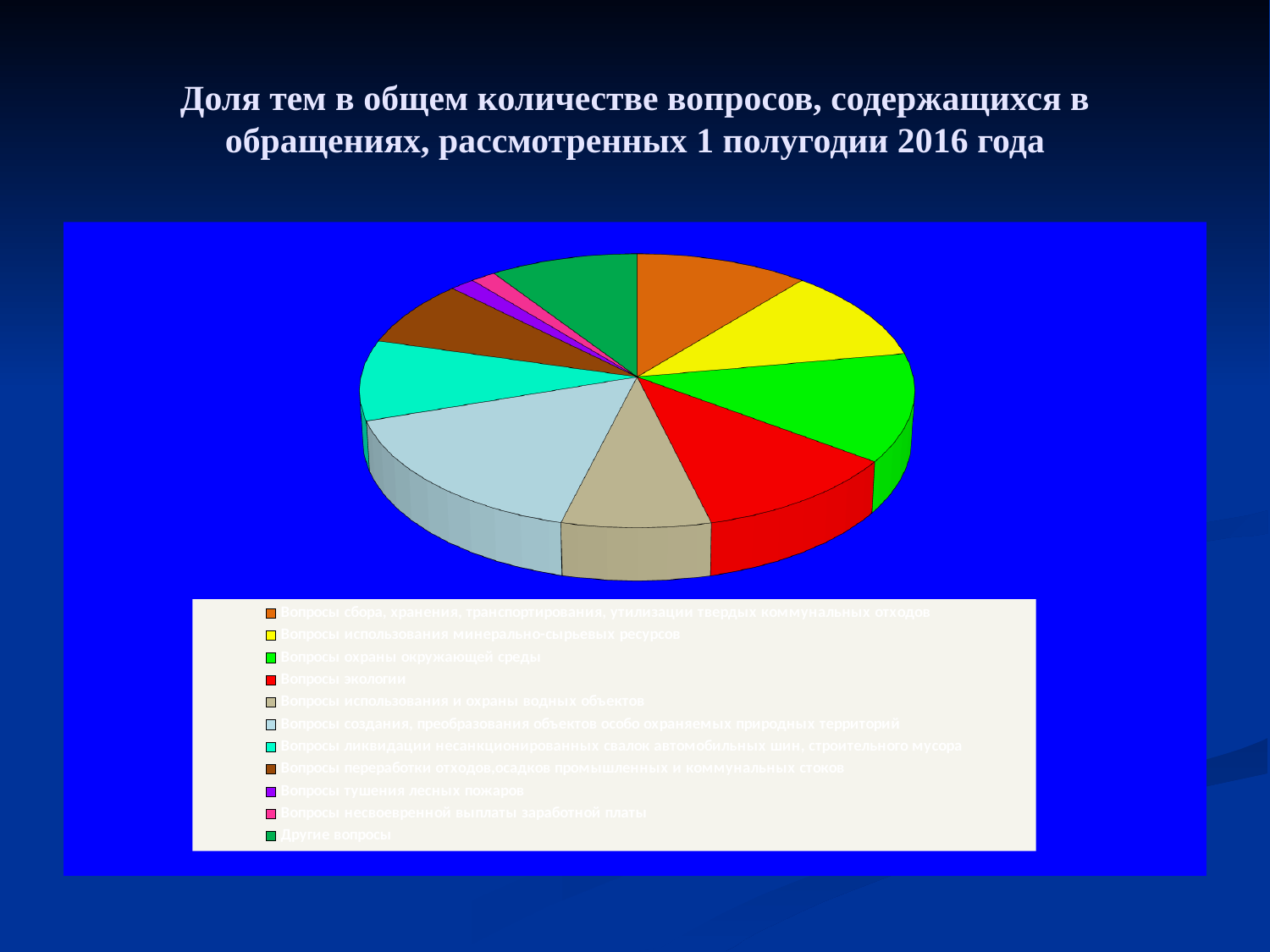
Which category has the largest slice in the pie chart? Вопросы создания, преобразования объектов особо охраняемых природных территорий Which slice is larger: the red slice (Вопросы экологии) or the pink slice (Вопросы несвоевременной выплаты заработной платы)? Вопросы экологии How many entries does the legend of the pie chart list? 11 Which slice is larger: the light blue slice (Вопросы создания, преобразования объектов особо охраняемых природных территорий) or the purple slice (Вопросы тушения лесных пожаров)? Вопросы создания, преобразования объектов особо охраняемых природных территорий What colour is the slice for Вопросы экологии in the pie chart? red What is the title of the chart on the slide? Доля тем в общем количестве вопросов, содержащихся в обращениях, рассмотренных 1 полугодии 2016 года What kind of chart is shown on the slide? pie chart How many slices does the pie chart have? 11